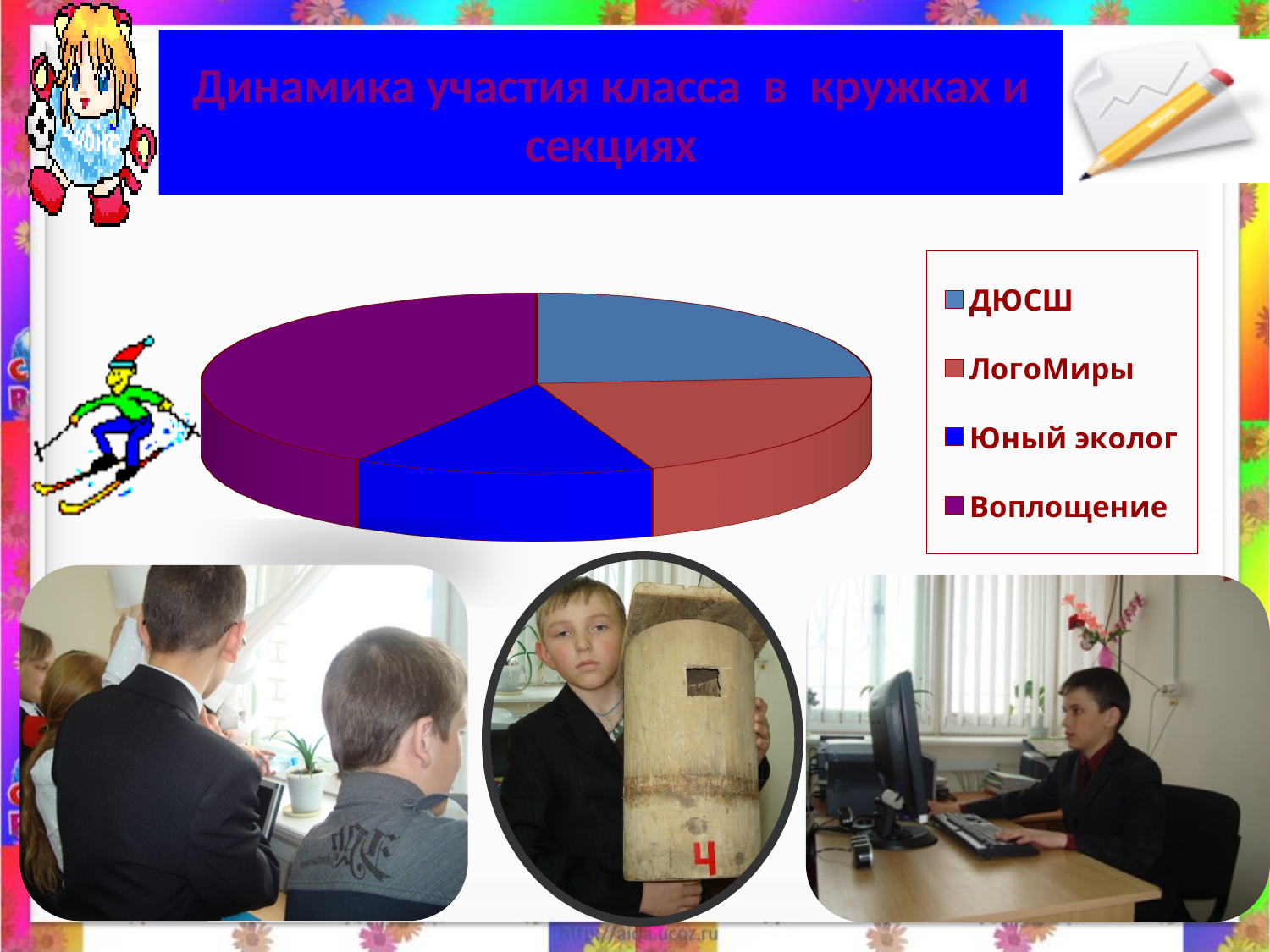
Which slice is larger, Воплощение or ДЮСШ? Воплощение Which legend entry is shown in purple? Воплощение How many entries does the chart legend list? 4 How many slices does the pie chart have? 4 Which category has the largest slice of the pie chart? Воплощение Which slice is larger, Воплощение or ЛогоМиры? Воплощение What kind of chart is shown on the slide? pie chart What is the title of the slide containing the pie chart? Динамика участия класса в кружках и секциях Which slice is larger, Воплощение or Юный эколог? Воплощение